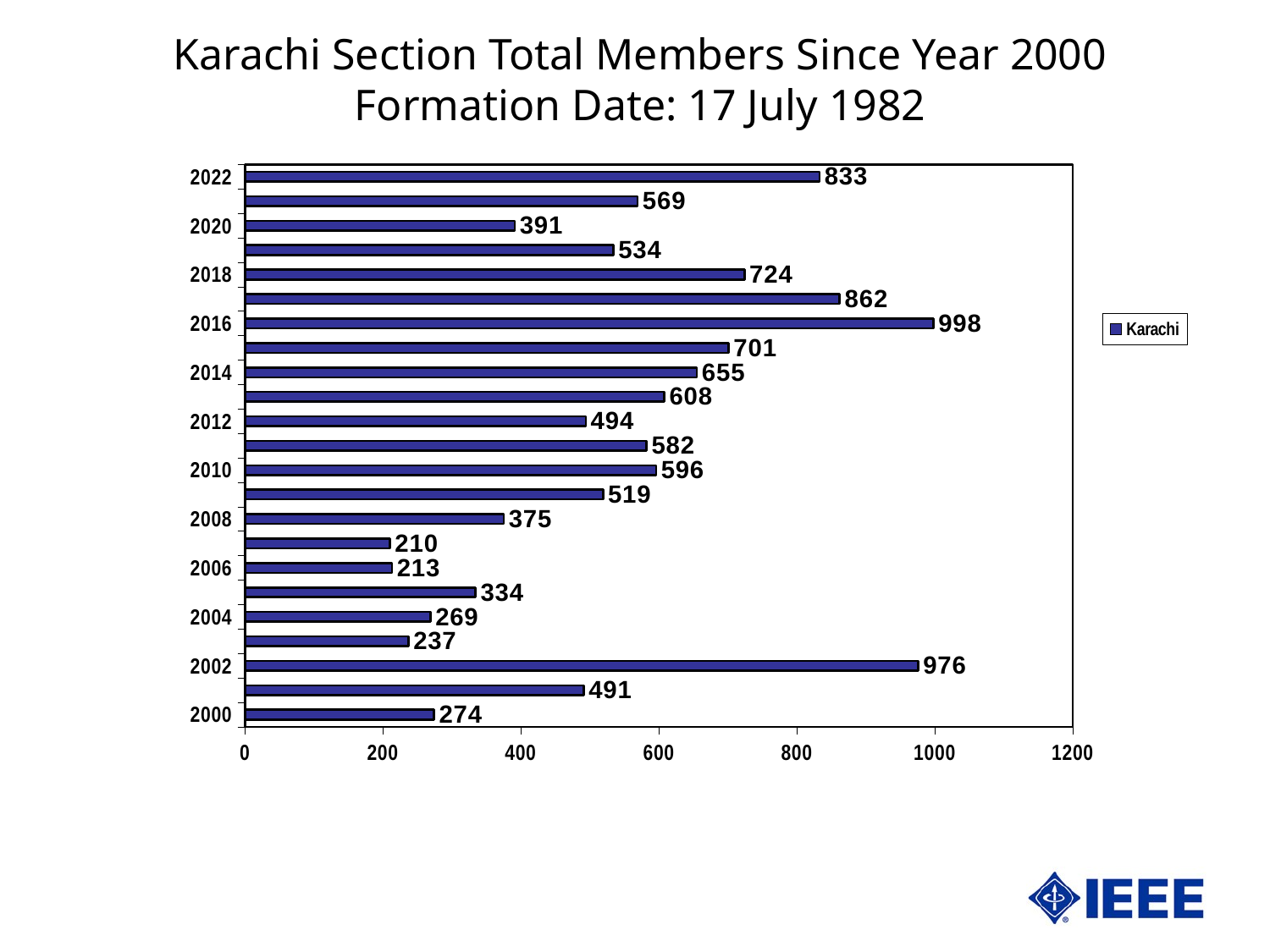
What is the value for 2016? 998 Is the value for 2006 greater or less than 400? less What is the value for 2022? 833 How many bars are plotted in the chart? 23 What is the value for 2002? 976 What is the value for 2000? 274 What is the difference between the values for 2022 and 2020? 442 How many series does the legend list? 1 Which year has the highest value? 2016 What kind of chart is shown? bar chart Which is larger, the value for 2018 or the value for 2010? 2018 What is the smallest value labeled on any bar? 210